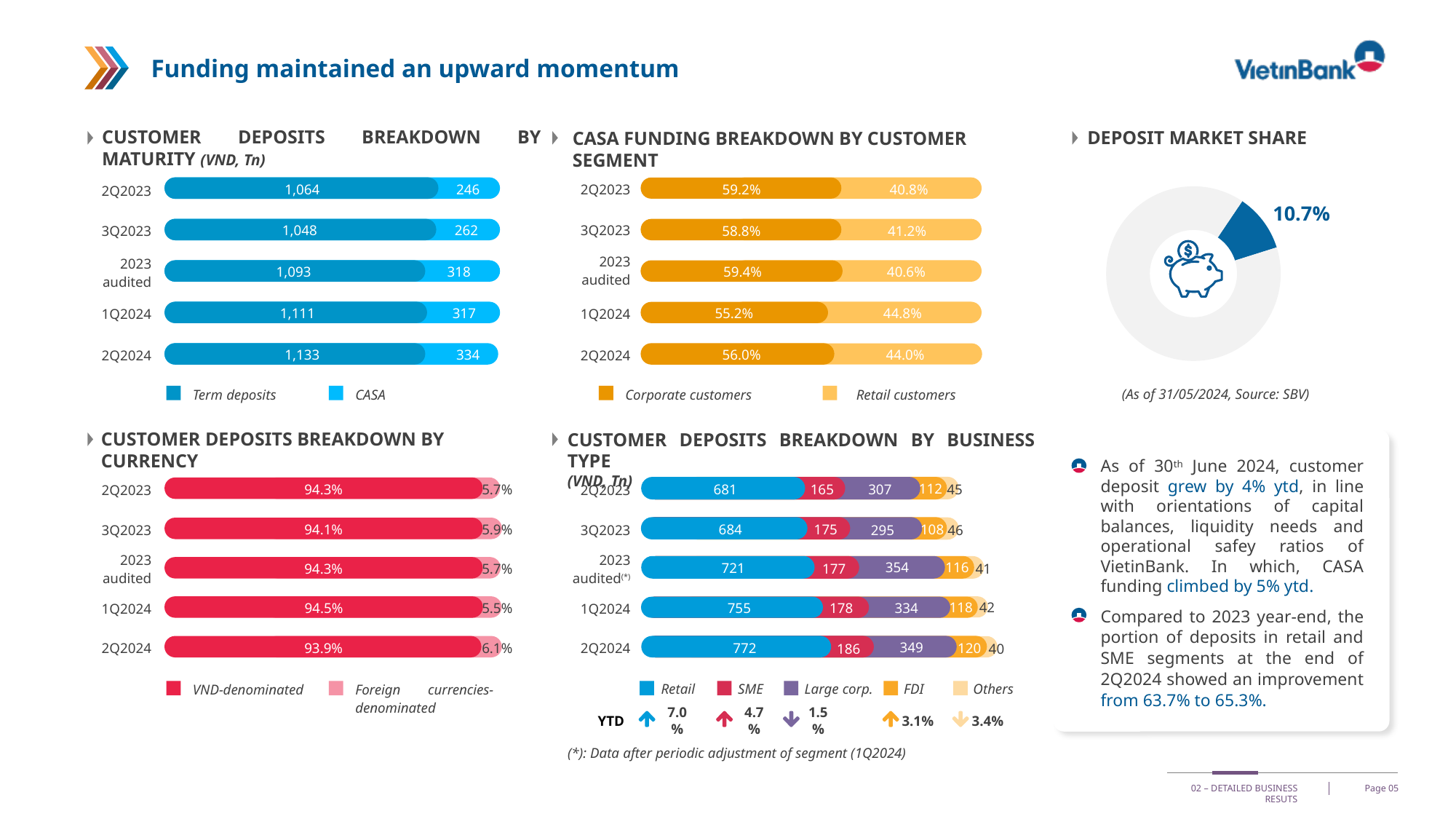
In the Customer Deposits Breakdown by Maturity chart, which period has the highest CASA value? 2Q2024 In the Customer Deposits Breakdown by Business Type chart, what is the difference between the Retail value in 2Q2024 and in 2Q2023? 91 How many series does the legend of the Customer Deposits Breakdown by Business Type chart list? 5 What kind of chart is the Customer Deposits Breakdown by Currency chart? Bar chart In the Deposit Market Share chart, what market share is shown? 10.7% In the CASA Funding Breakdown by Customer Segment chart, what is the share of corporate customers in 1Q2024? 55.2% In the Customer Deposits Breakdown by Business Type chart, what is the SME value for 2Q2024? 186 In the Customer Deposits Breakdown by Currency chart, what is the foreign currencies-denominated share for 2Q2024? 6.1% In the Customer Deposits Breakdown by Maturity chart, what is the total of term deposits and CASA for 2Q2024? 1,467 In the Customer Deposits Breakdown by Maturity chart, what is the CASA value for 2Q2023? 246 In the CASA Funding Breakdown by Customer Segment chart, which period has the lowest corporate customers share? 1Q2024 In the Customer Deposits Breakdown by Maturity chart, what is the value of term deposits for 2Q2024? 1,133